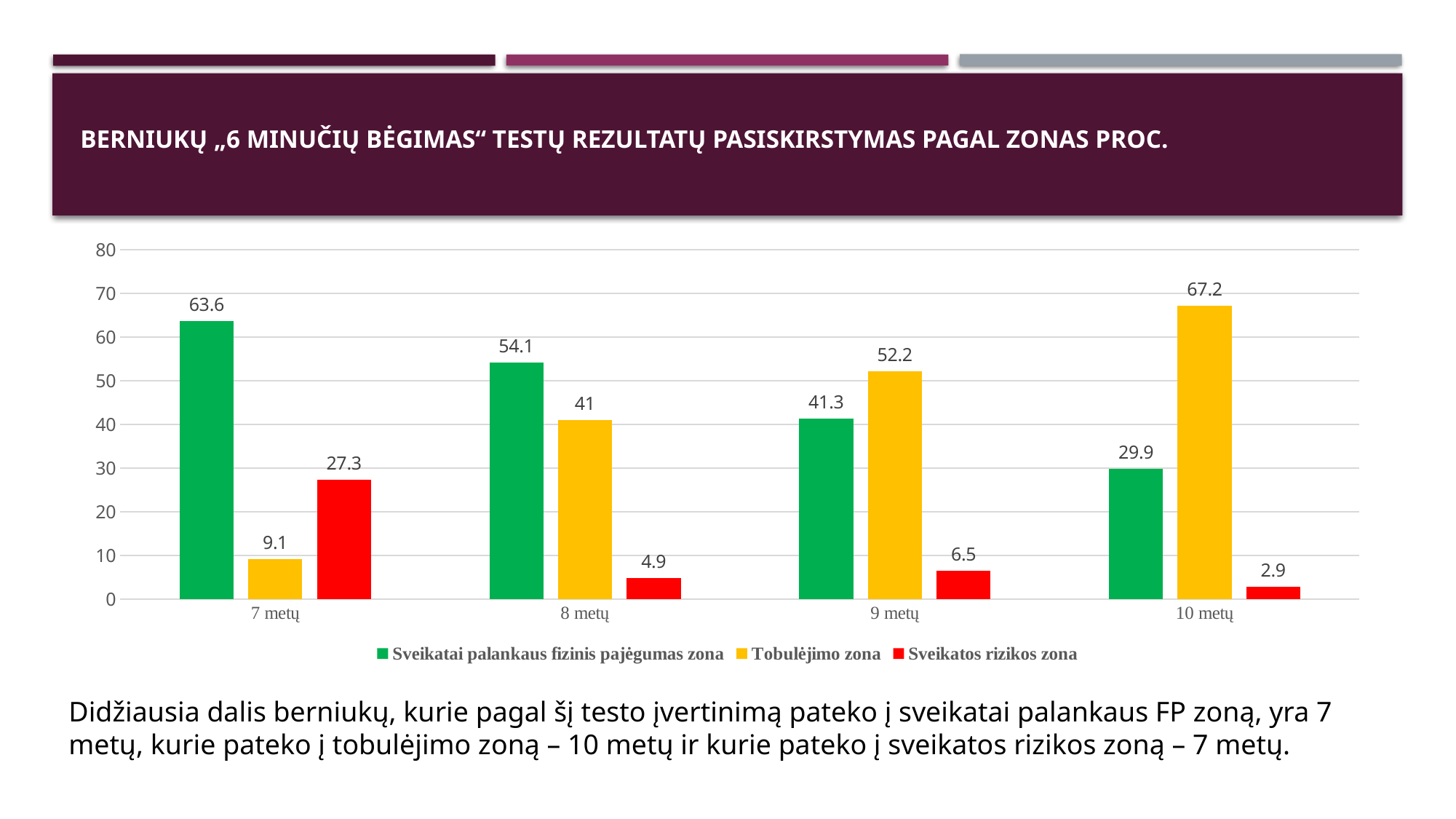
Which is larger at 9 metų: 'Sveikatai palankaus fizinis pajėgumas zona' or 'Tobulėjimo zona'? Tobulėjimo zona What is the value for 'Tobulėjimo zona' at 10 metų? 67.2 How many series does the legend list? 3 What is the value for 'Sveikatos rizikos zona' at 8 metų? 4.9 What kind of chart is shown on the slide? Bar chart Which age group has the highest value for 'Sveikatos rizikos zona'? 7 metų What is the value for 'Sveikatai palankaus fizinis pajėgumas zona' at 7 metų? 63.6 What is the difference between the 'Tobulėjimo zona' values at 10 metų and 7 metų? 58.1 How many age groups are shown on the x axis? 4 Which colour represents 'Sveikatos rizikos zona' in the chart? Red Which age group has the lowest value for 'Sveikatai palankaus fizinis pajėgumas zona'? 10 metų Is the value for 'Sveikatai palankaus fizinis pajėgumas zona' at 8 metų greater or less than 50? greater